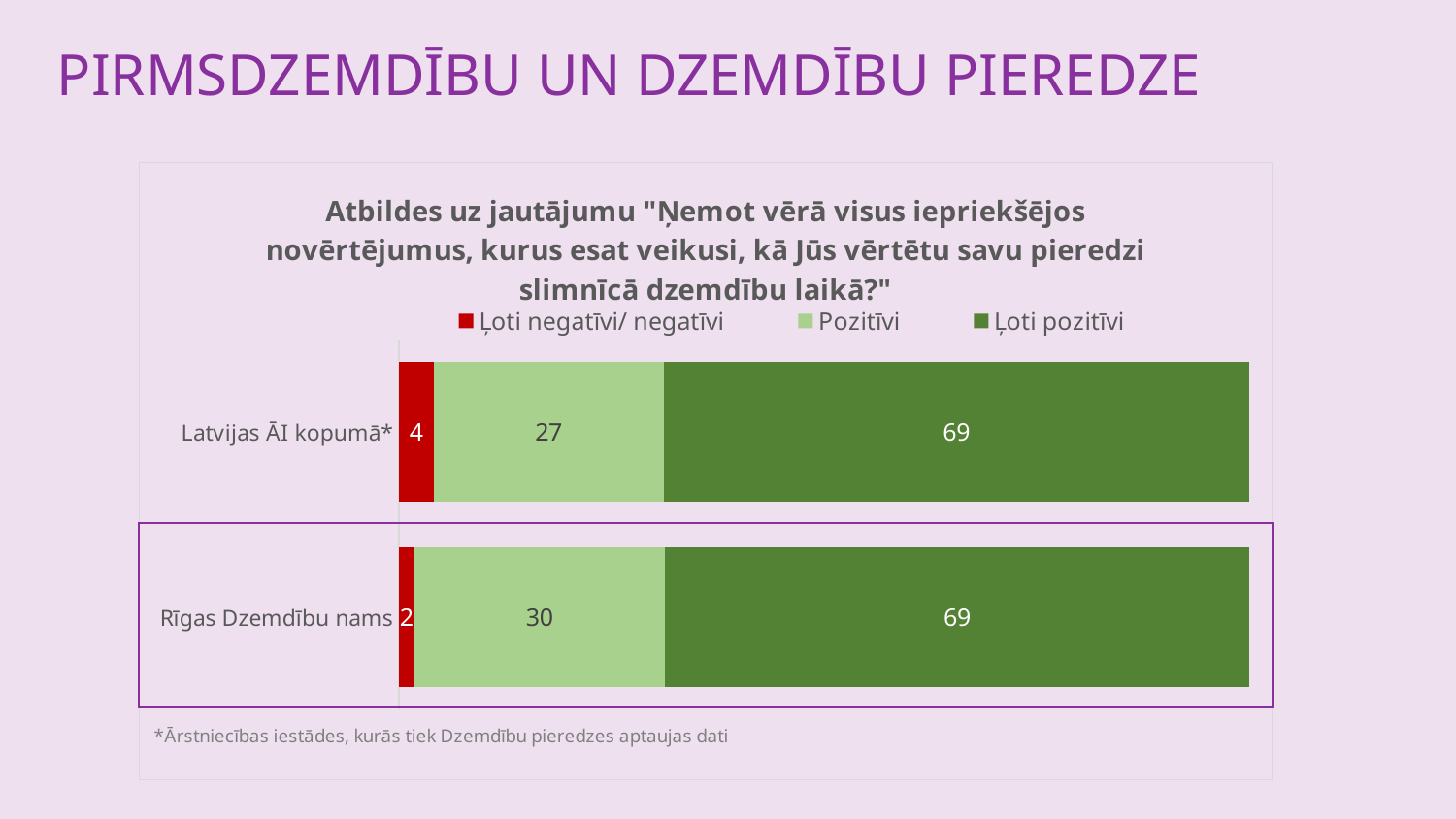
What kind of chart is shown on the slide? Stacked bar chart How many categories are shown in the chart? 2 What is the value for "Ļoti negatīvi/ negatīvi" for Rīgas Dzemdību nams? 2 What is the value for "Ļoti negatīvi/ negatīvi" for Latvijas ĀI kopumā*? 4 What is the total of the stacked bar for Latvijas ĀI kopumā*? 100 What is the value for "Ļoti pozitīvi" for Rīgas Dzemdību nams? 69 What is the value for "Pozitīvi" for Latvijas ĀI kopumā*? 27 How many series does the legend list? 3 Which category has the higher "Pozitīvi" value? Rīgas Dzemdību nams What is the difference between the "Pozitīvi" values for Rīgas Dzemdību nams and Latvijas ĀI kopumā*? 3 What is the total of the stacked bar for Rīgas Dzemdību nams? 101 What is the difference between the "Ļoti negatīvi/ negatīvi" values for Latvijas ĀI kopumā* and Rīgas Dzemdību nams? 2